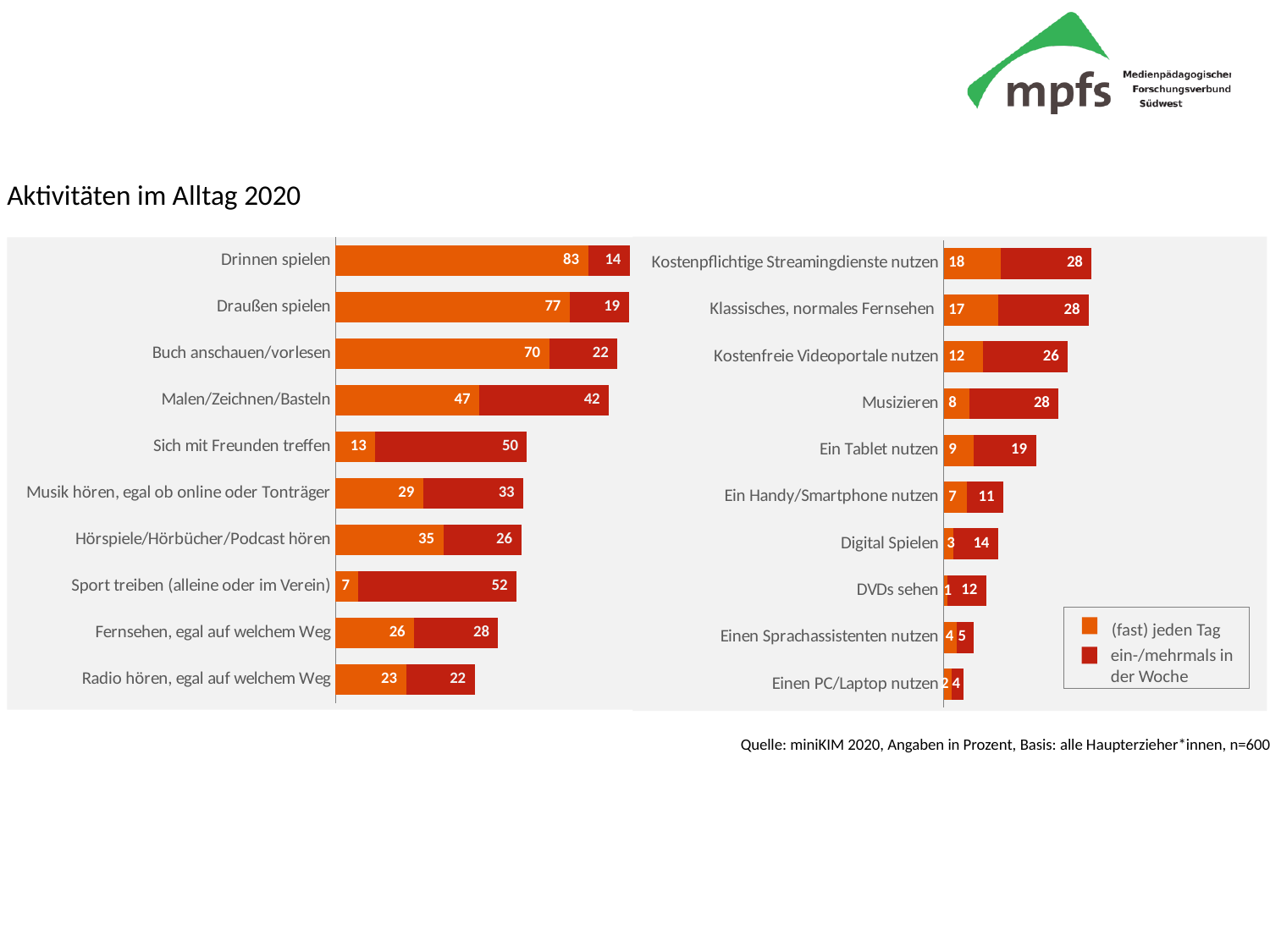
How many series does the legend list? 2 In the left chart, which is larger: the 'ein-/mehrmals in der Woche' value for 'Sport treiben (alleine oder im Verein)' or for 'Sich mit Freunden treffen'? Sport treiben (alleine oder im Verein) What kind of chart is shown on the left side of the slide? Stacked bar chart In the left chart, what is the total of the stacked bar for 'Malen/Zeichnen/Basteln'? 89 In the left chart, what is the '(fast) jeden Tag' value for 'Drinnen spielen'? 83 In the left chart, which category has the highest '(fast) jeden Tag' value? Drinnen spielen In the right chart, what is the total of the stacked bar for 'Ein Tablet nutzen'? 28 How many categories does the right chart show? 10 Which series is shown in orange according to the legend? (fast) jeden Tag In the left chart, what is the difference between the '(fast) jeden Tag' values for 'Draußen spielen' and 'Buch anschauen/vorlesen'? 7 In the right chart, which category has the lowest 'ein-/mehrmals in der Woche' value? Einen PC/Laptop nutzen In the right chart, what is the 'ein-/mehrmals in der Woche' value for 'Kostenfreie Videoportale nutzen'? 26